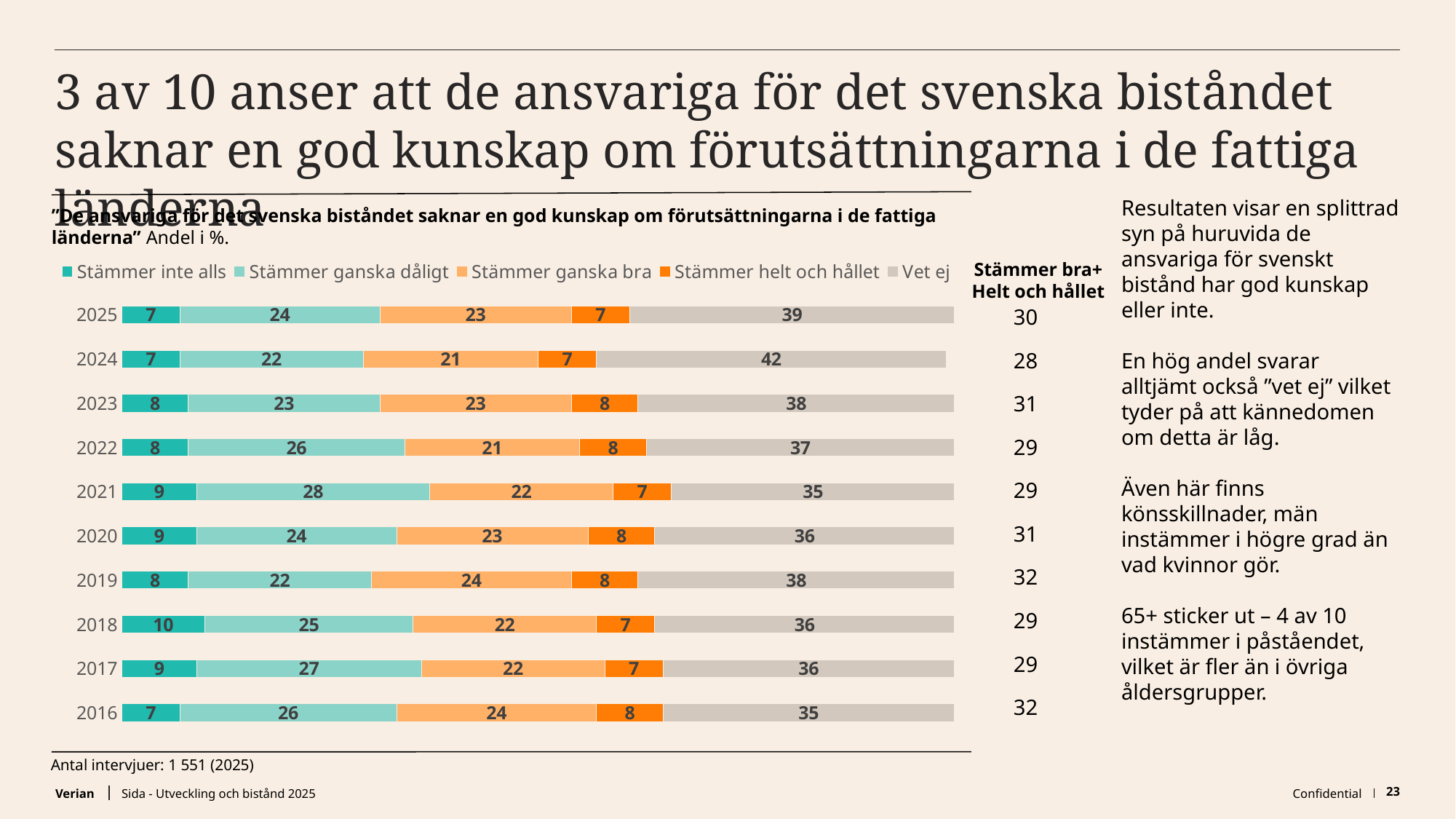
What is the difference between the "Vet ej" values for 2024 and 2025? 3 Which year has the larger "Stämmer ganska bra" value, 2019 or 2024? 2019 How many years are shown in the chart? 10 What is the value for "Stämmer ganska dåligt" in 2021? 28 What is the first entry in the chart legend? Stämmer inte alls In which year is the "Vet ej" value highest? 2024 What is the value for "Vet ej" in 2025? 39 What is the value for "Stämmer helt och hållet" in 2022? 8 In which year is the "Stämmer inte alls" value highest? 2018 What is the total of the stacked bar for 2024? 99 What kind of chart is shown on the slide? Stacked bar chart How many series does the legend list? 5